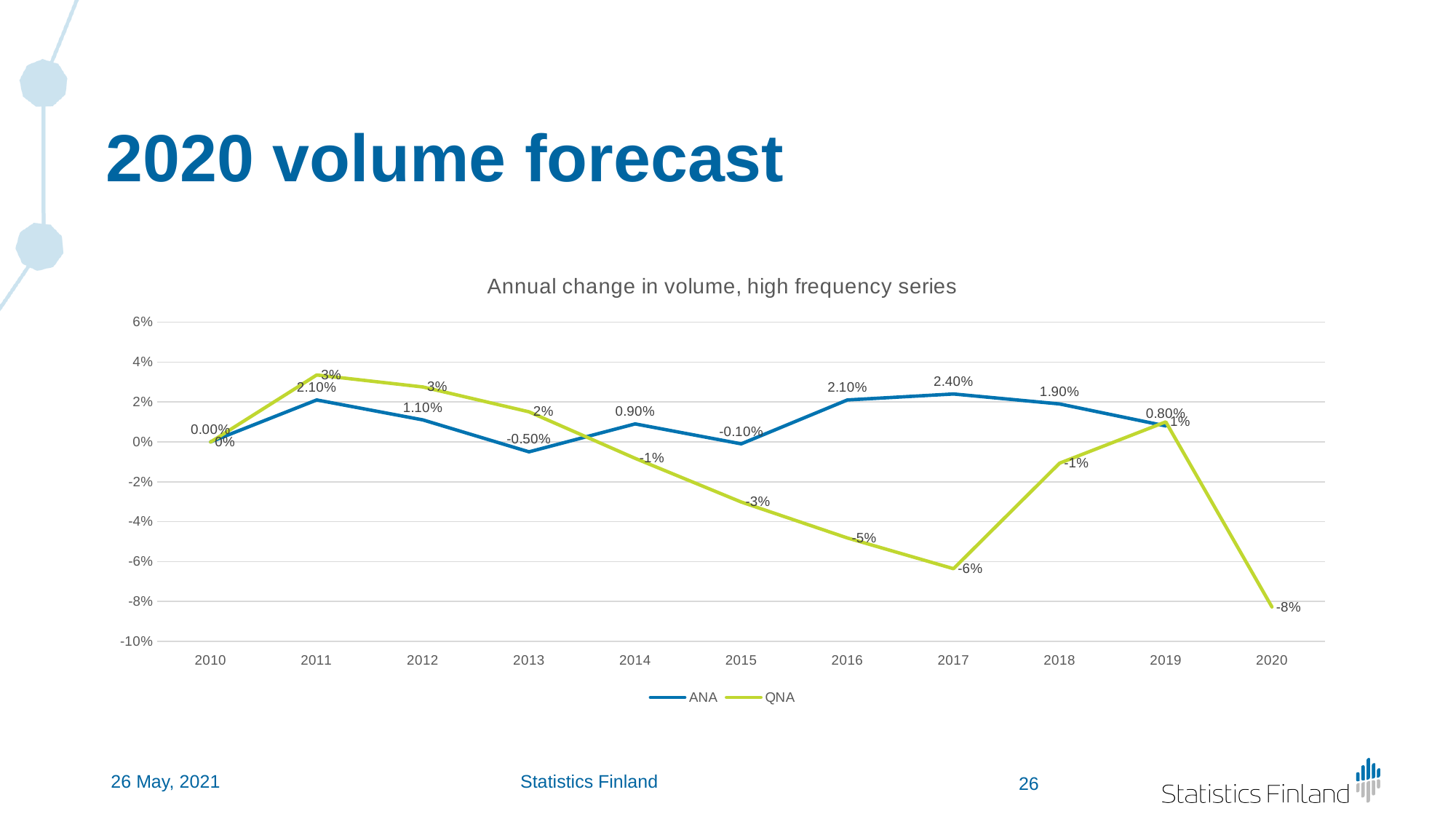
What kind of chart is shown on the slide? Line chart In which year does the ANA series reach its highest value? 2017 In 2016, which series has the larger value, ANA or QNA? ANA What is the difference between the QNA values for 2017 and 2018? 5% Does the QNA series rise or fall from 2013 to 2017? Fall What is the ANA value for 2013? -0.50% What is the ANA value for 2017? 2.40% How many years are shown on the x axis? 11 What is the difference between the ANA values for 2018 and 2019? 1.10% What is the QNA value for 2020? -8% How many series does the legend list? 2 In which year does the QNA series reach its lowest value? 2020